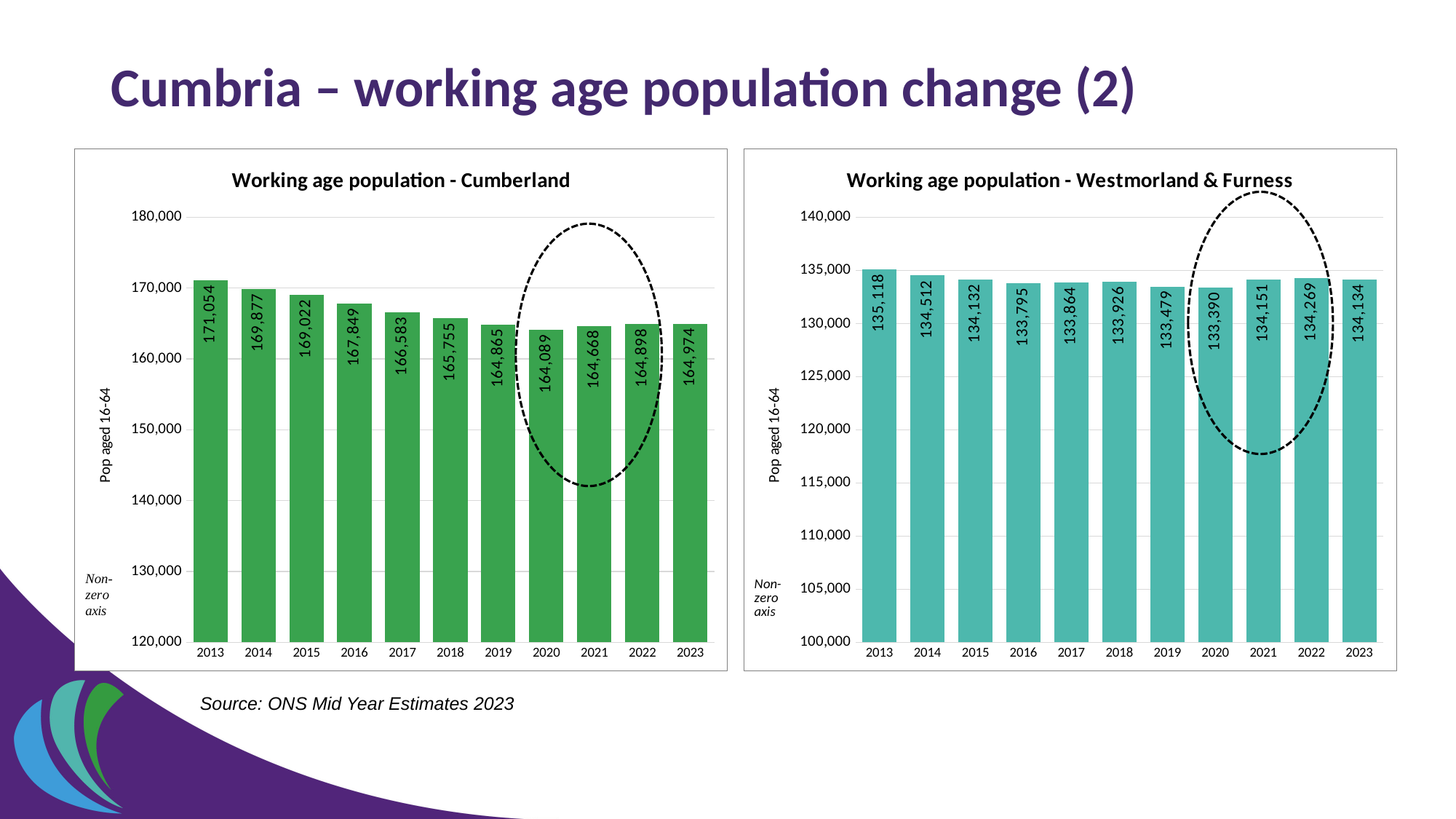
In the 'Working age population - Cumberland' chart, what is the value for 2013? 171,054 In the 'Working age population - Cumberland' chart, is the value for 2016 greater or less than 170,000? less In the 'Working age population - Cumberland' chart, what is the difference between the 2013 and 2023 values? 6,080 In the 'Working age population - Westmorland & Furness' chart, which year has the highest value? 2013 In the 'Working age population - Westmorland & Furness' chart, what is the value for 2023? 134,134 In the 'Working age population - Westmorland & Furness' chart, what is the value for 2019? 133,479 In the 'Working age population - Cumberland' chart, what is the value for 2020? 164,089 In the 'Working age population - Cumberland' chart, which year has the lowest value? 2020 In the 'Working age population - Cumberland' chart, which year has the highest value? 2013 How many years are shown on the x axis of the 'Working age population - Cumberland' chart? 11 What kind of chart is the 'Working age population - Westmorland & Furness' chart? bar chart In the 'Working age population - Westmorland & Furness' chart, what is the difference between the 2022 and 2021 values? 118